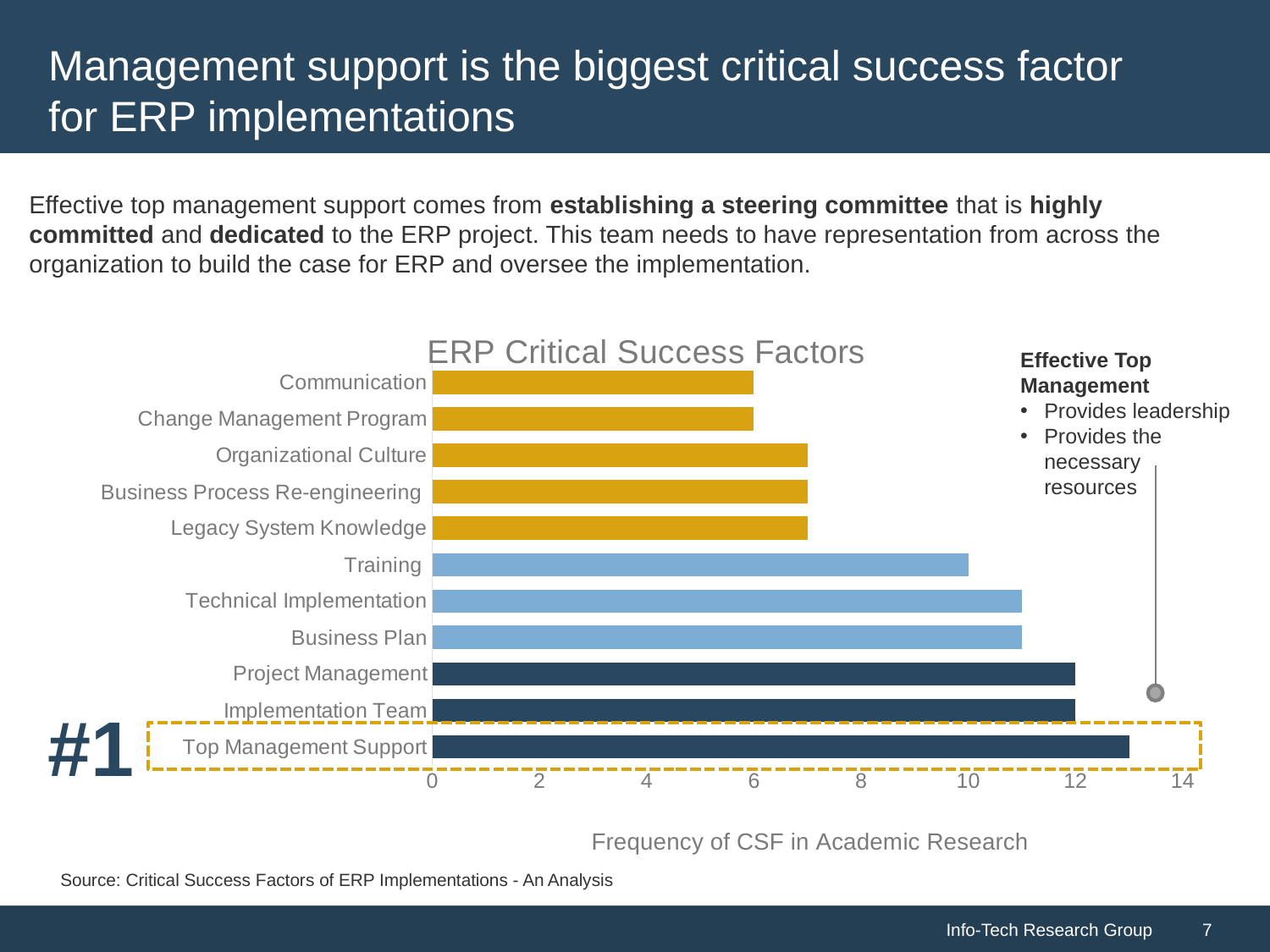
What is the frequency value for Training? 10 Is the value for Organizational Culture greater or less than 8? less Which has a higher frequency, Training or Change Management Program? Training Is the value for Top Management Support greater or less than 12? greater What is the frequency value for Communication? 6 How many critical success factors are plotted in the chart? 11 What type of chart is shown on the slide? Bar chart What is the label on the horizontal axis of the chart? Frequency of CSF in Academic Research What is the difference between the frequency for Project Management and the frequency for Communication? 6 What is the title of the chart? ERP Critical Success Factors What is the frequency value for Project Management? 12 Which critical success factor has the highest frequency in the chart? Top Management Support